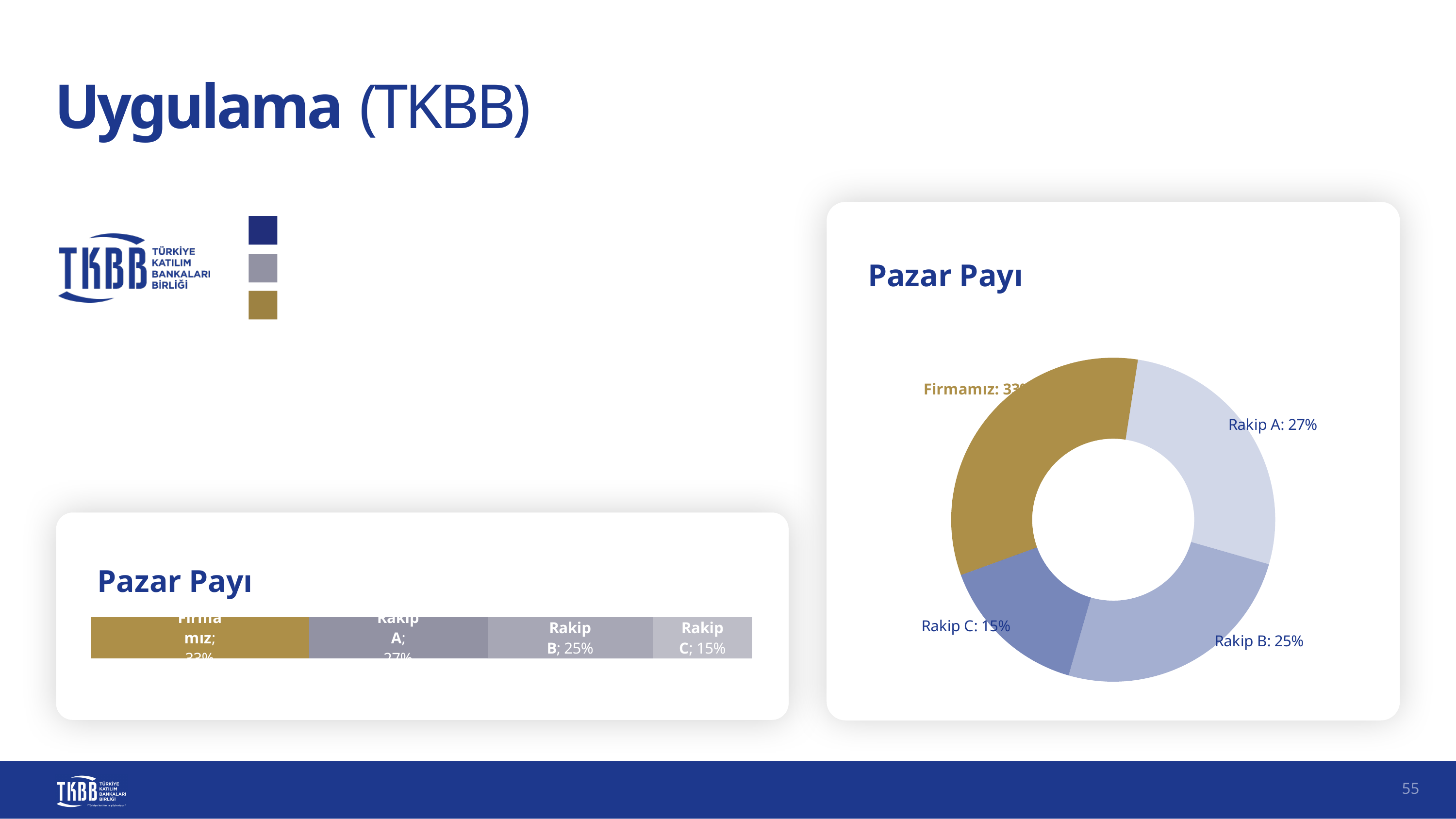
In the donut chart on the right, which category has the smallest share? Rakip C In the donut chart on the right, what is the market share of Rakip B? 25% How many categories are shown in the donut chart on the right? 4 What kind of chart is the chart on the left side of the slide? Bar chart In the donut chart on the right, which category has the largest share? Firmamız In the donut chart on the right, which has the larger share, Rakip A or Rakip B? Rakip A In the stacked bar chart on the left, what value is shown for Rakip B? 25% In the stacked bar chart on the left, what value is shown for Rakip C? 15% In the donut chart on the right, what is the difference between the shares of Rakip A and Rakip C? 12% In the donut chart on the right, what is the market share of Rakip A? 27% In the donut chart on the right, what is the market share of Rakip C? 15% What kind of chart is the chart on the right side of the slide? Donut chart